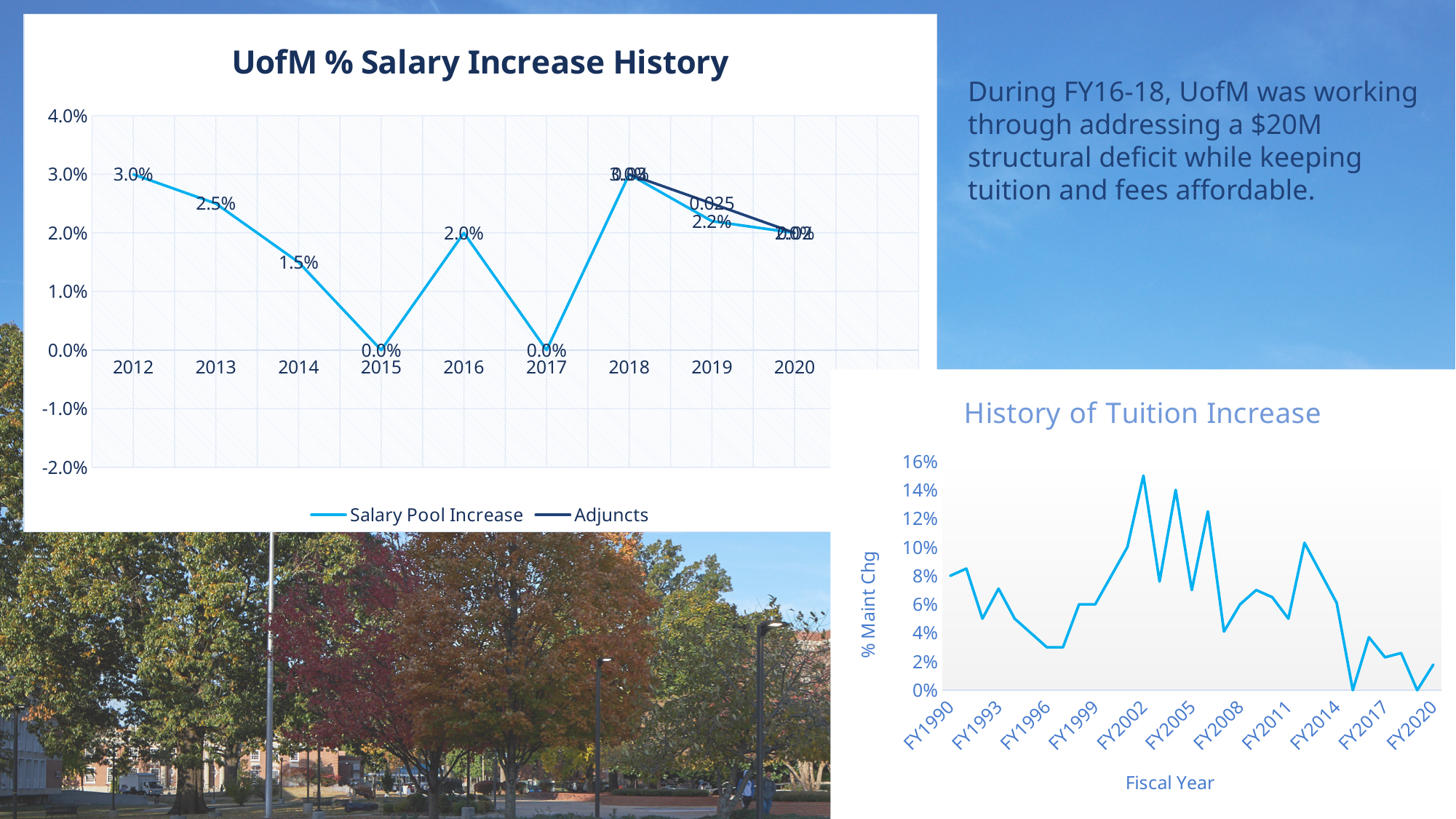
In the 'UofM % Salary Increase History' chart, what is the Salary Pool Increase for 2019? 2.2% How many series does the legend of the 'UofM % Salary Increase History' chart list? 2 In the 'UofM % Salary Increase History' chart, what is the Salary Pool Increase for 2013? 2.5% In the 'UofM % Salary Increase History' chart, what is the difference between the Salary Pool Increase in 2012 and in 2014? 1.5% In the 'UofM % Salary Increase History' chart, what is the Salary Pool Increase for 2014? 1.5% What kind of chart is 'History of Tuition Increase'? Line chart How many years are shown on the x axis of the 'UofM % Salary Increase History' chart? 9 What is the y-axis title of the 'History of Tuition Increase' chart? % Maint Chg In the 'History of Tuition Increase' chart, is the value for FY2020 greater or less than 4%? less In the 'UofM % Salary Increase History' chart, which is larger, the Salary Pool Increase in 2016 or in 2019? 2019 In the 'UofM % Salary Increase History' chart, which years have a Salary Pool Increase of 0.0%? 2015 and 2017 In the 'UofM % Salary Increase History' chart, what value is labelled for the Adjuncts series in 2019? 0.025